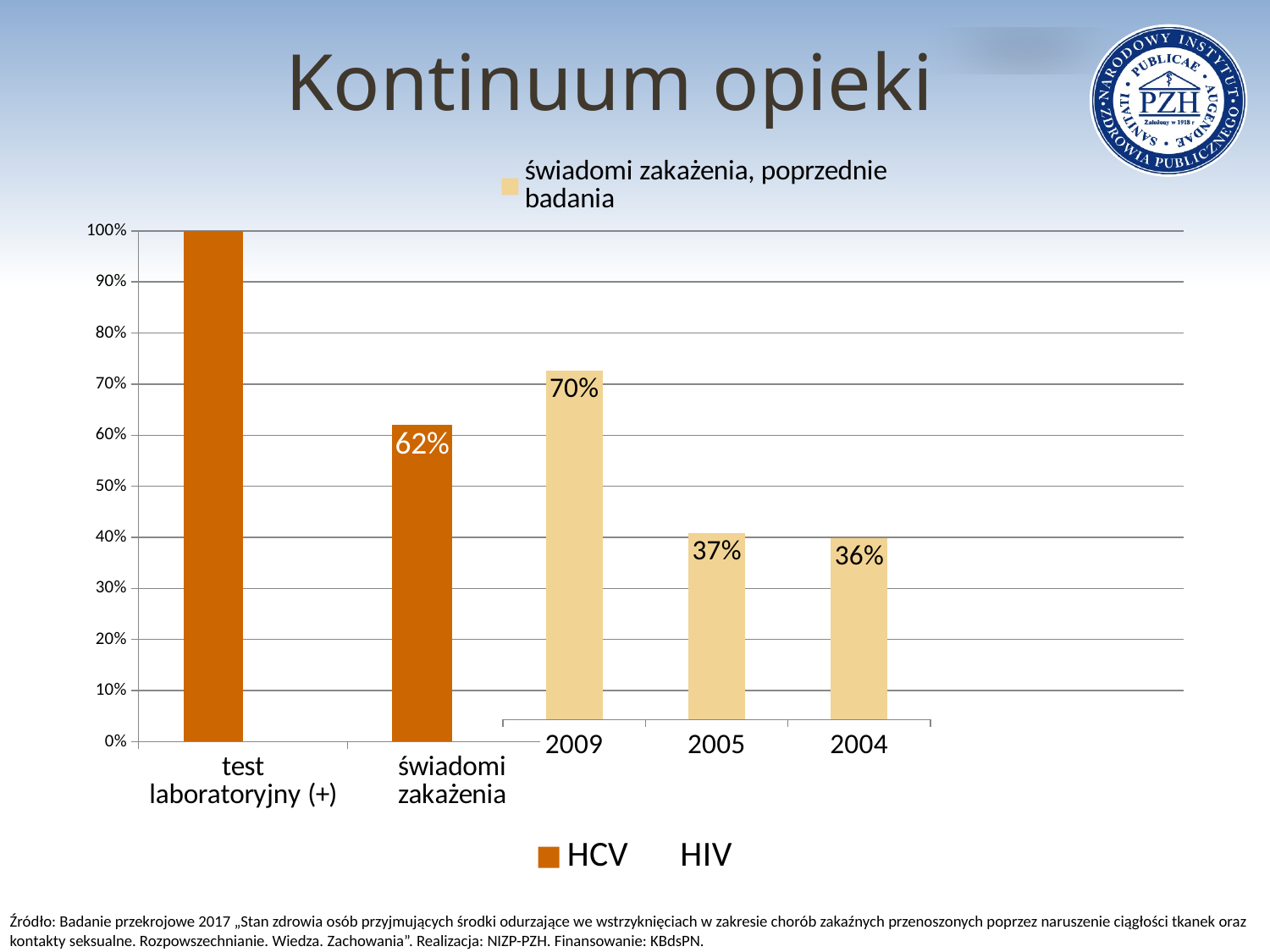
Which is larger: the 2009 value or the HCV 'świadomi zakażenia' value? 2009 Among the years 2009, 2005 and 2004, which has the highest value? 2009 What is the HCV value for 'świadomi zakażenia'? 62% What is the value shown for 2009 in the 'świadomi zakażenia, poprzednie badania' bars? 70% What is the value shown for 2005 in the 'świadomi zakażenia, poprzednie badania' bars? 37% Among the years 2009, 2005 and 2004, which has the lowest value? 2004 What is the HCV value for 'test laboratoryjny (+)'? 100% Which series are listed in the legend at the bottom of the chart? HCV, HIV What type of chart is shown on the slide? bar chart What is the difference between the 2009 value and the 2005 value? 33% What is the value shown for 2004 in the 'świadomi zakażenia, poprzednie badania' bars? 36% What is the difference between the HCV values for 'test laboratoryjny (+)' and 'świadomi zakażenia'? 38%